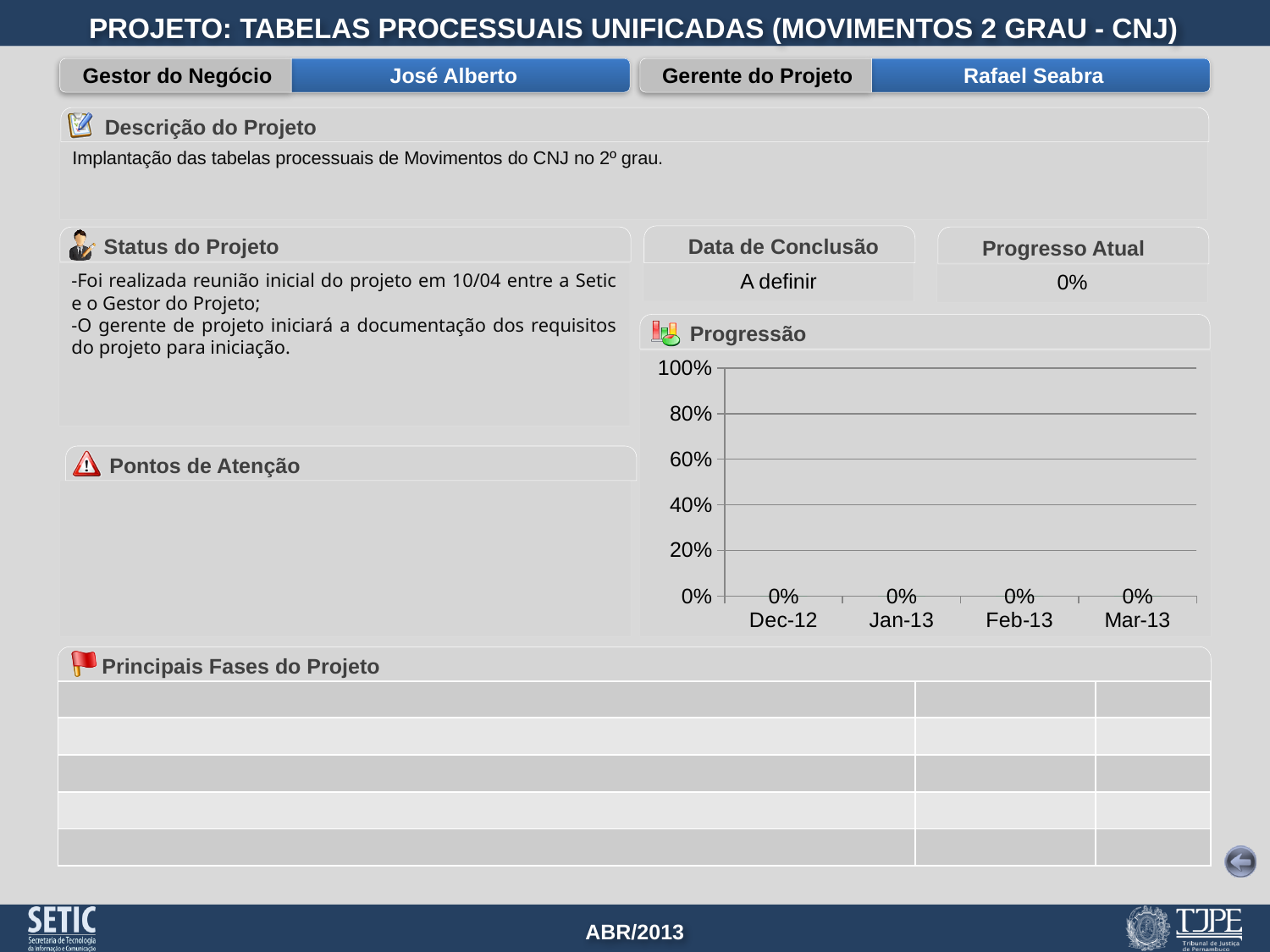
How many categories are shown on the x axis of the Progressão chart? 4 Do the values in the Progressão chart rise, fall, or stay flat from Dec-12 to Mar-13? stay flat What is the highest value shown on the y axis of the Progressão chart? 100% In the Progressão chart, what is the value for Mar-13? 0% In the Progressão chart, what is the value for Dec-12? 0% In the Progressão chart, what is the value for Feb-13? 0% What is the title of the chart on the slide? Progressão In the Progressão chart, which is the first category on the x axis? Dec-12 In the Progressão chart, is the value for Mar-13 greater or less than 40%? less In the Progressão chart, what is the value for Jan-13? 0% In the Progressão chart, is the value for Jan-13 greater or less than 20%? less In the Progressão chart, what is the difference between the values for Dec-12 and Mar-13? 0%